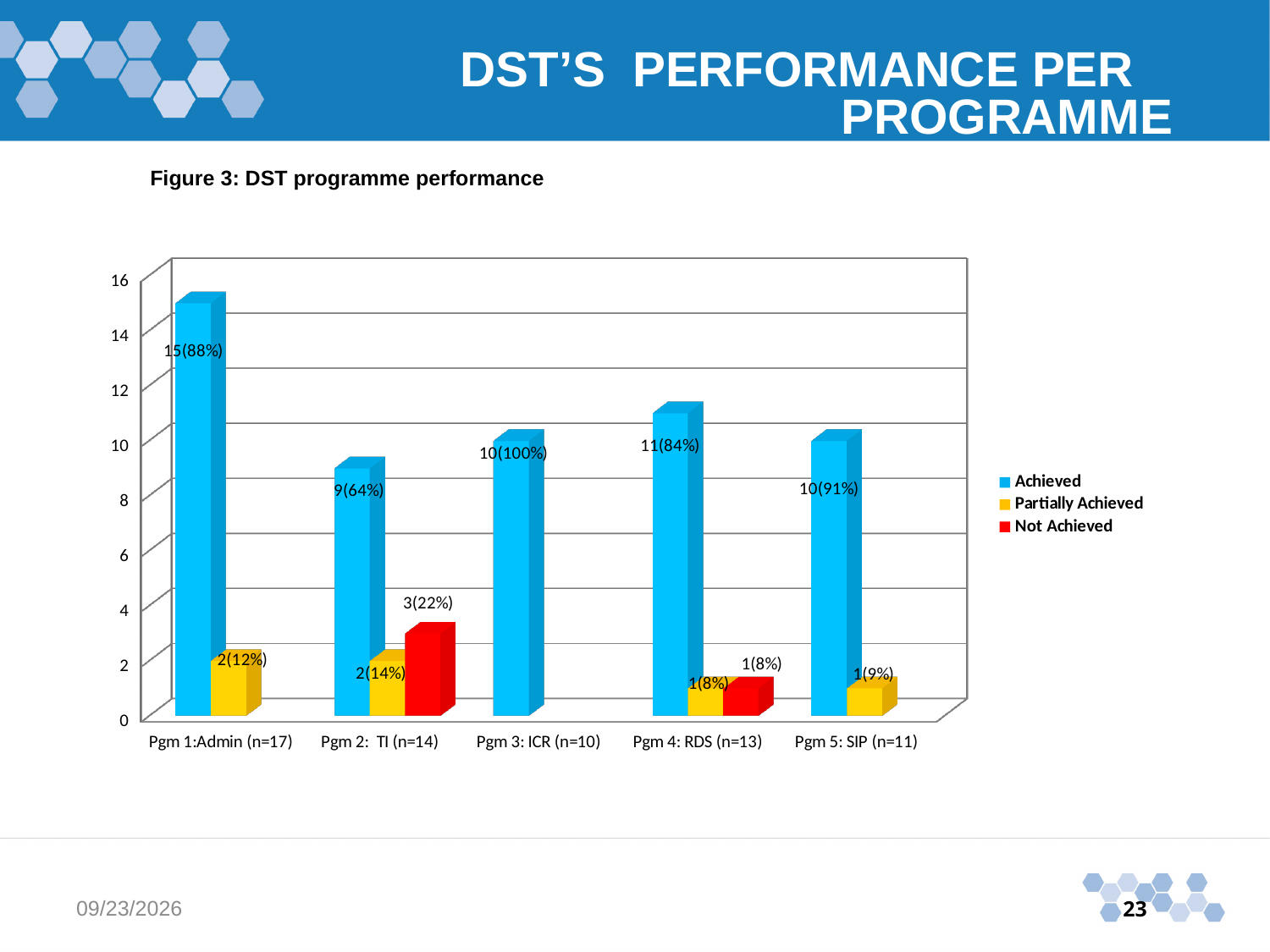
What is the data label on the Achieved bar for Pgm 1:Admin (n=17)? 15(88%) What is the data label on the Achieved bar for Pgm 3: ICR (n=10)? 10(100%) Which programme has the lowest Achieved bar? Pgm 2: TI (n=14) What kind of chart is shown on the slide? Bar chart How many programmes are shown on the x axis? 5 How many series does the legend list? 3 What is the data label on the Not Achieved bar for Pgm 2: TI (n=14)? 3(22%) Which is larger, the Achieved count for Pgm 4: RDS (n=13) or for Pgm 5: SIP (n=11)? Pgm 4: RDS (n=13) Which programme has the highest Achieved bar? Pgm 1:Admin (n=17) Which colour represents the Not Achieved series in the legend? Red What is the data label on the Partially Achieved bar for Pgm 5: SIP (n=11)? 1(9%) How many more targets were achieved in Pgm 1:Admin (n=17) than in Pgm 2: TI (n=14)? 6